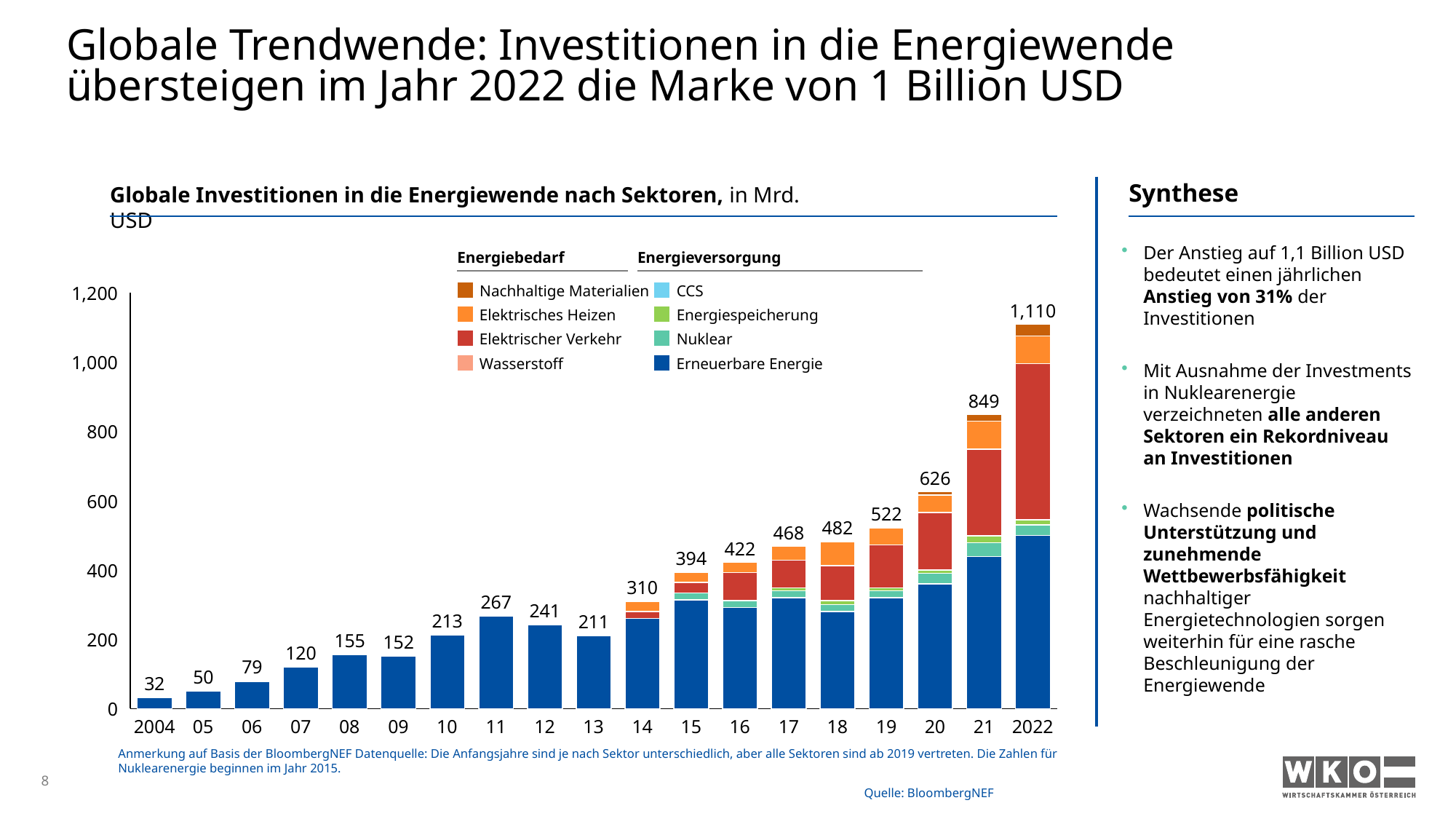
Do the total investments generally rise or fall from 2004 to 2022? Rise Which year has the larger total, 2011 or 2012? 2011 Is the Erneuerbare Energie segment of the 2022 bar greater or less than 400? greater What kind of chart is shown? Stacked bar chart Which year has the highest total investment? 2022 How many years (bars) are shown on the x axis? 19 What is the total value of the bar for 2015? 394 What is the total value of the bar for 2022? 1,110 What is the total of the stacked bar for 2020? 626 How many series does the legend list? 8 Which year has the lowest total investment? 2004 What is the difference between the total for 2022 and the total for 2021? 261